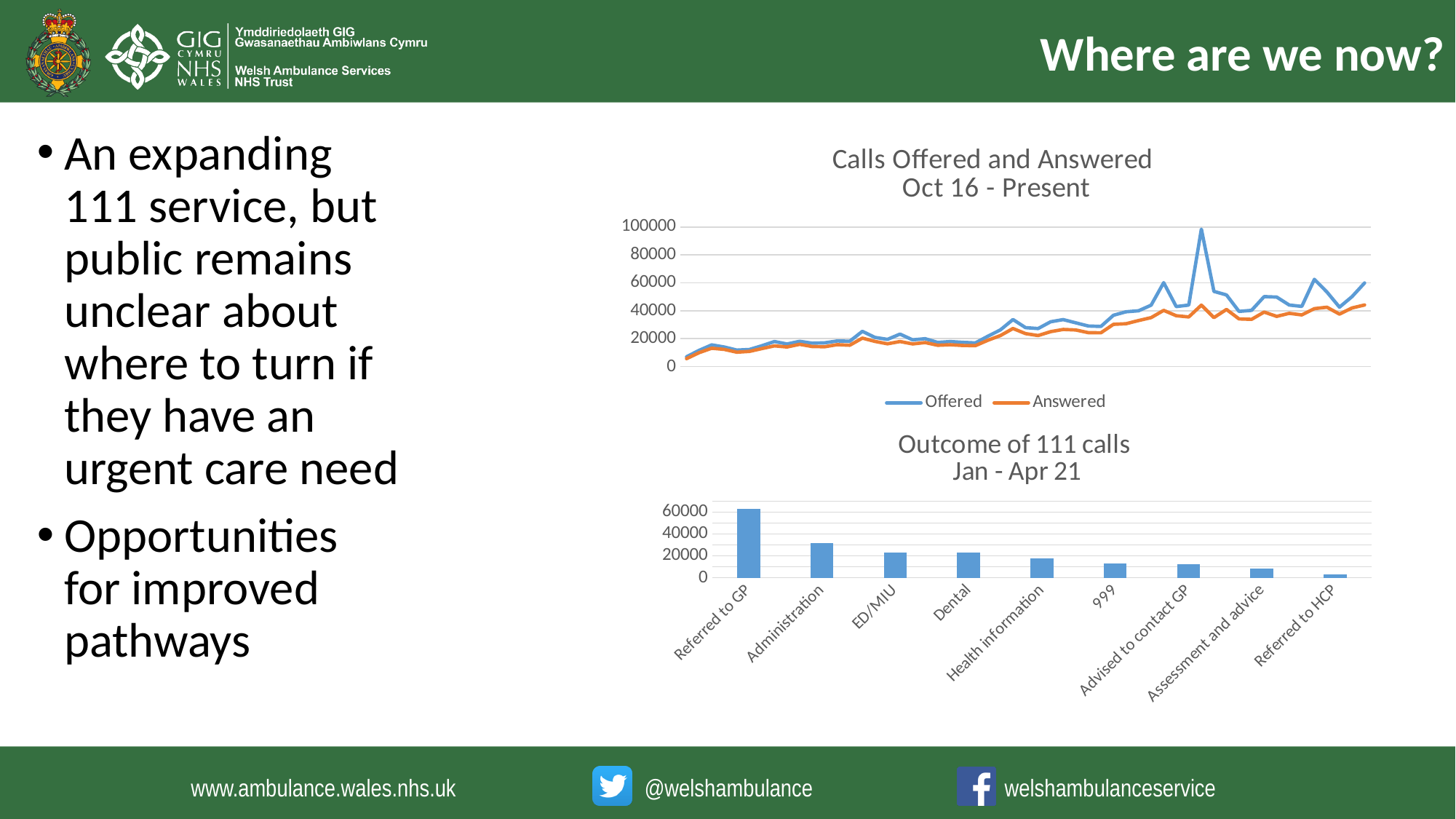
In the 'Calls Offered and Answered' chart, is the highest value of the Answered series greater or less than 60000? less In the 'Calls Offered and Answered' chart, do the values generally rise or fall from Oct 16 to the present? rise How many series does the legend of the 'Calls Offered and Answered' chart list? 2 In the 'Outcome of 111 calls' chart, which category has the lowest value? Referred to HCP In the 'Outcome of 111 calls' chart, which category has the highest value? Referred to GP In the 'Outcome of 111 calls' chart, which is larger, Administration or Health information? Administration How many categories are shown in the 'Outcome of 111 calls Jan - Apr 21' chart? 9 In the 'Calls Offered and Answered' chart, is the highest peak of the Offered series greater or less than 80000? greater In the 'Outcome of 111 calls' chart, is the value for Administration greater or less than 40000? less What kind of chart is the 'Calls Offered and Answered Oct 16 - Present' chart? line chart What kind of chart is the 'Outcome of 111 calls Jan - Apr 21' chart? bar chart In the 'Calls Offered and Answered' chart, which series is shown in orange? Answered